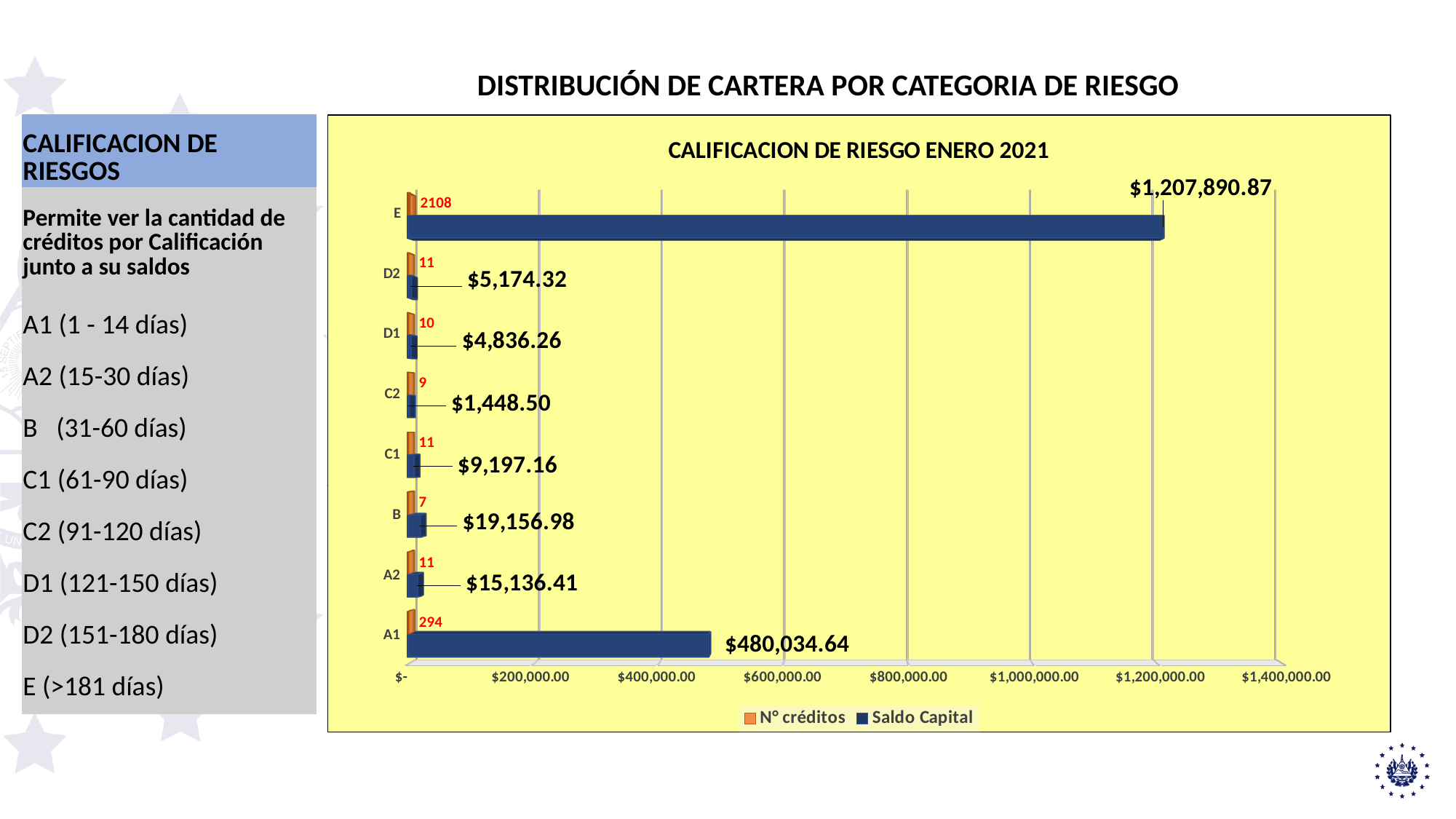
What is the Nº créditos value for category D1? 10 What is the Saldo Capital value for category B? $19,156.98 How many series does the legend list? 2 What is the Saldo Capital value for category E? $1,207,890.87 Which category has the lowest Saldo Capital? C2 Which has a larger Saldo Capital, D2 or D1? D2 What is the difference in Saldo Capital between E and A1? $727,856.23 What is the Nº créditos value for category A1? 294 Which category has the highest Saldo Capital? E What type of chart is shown? Bar chart How many categories are shown on the chart? 8 Which category has the lowest Nº créditos? B